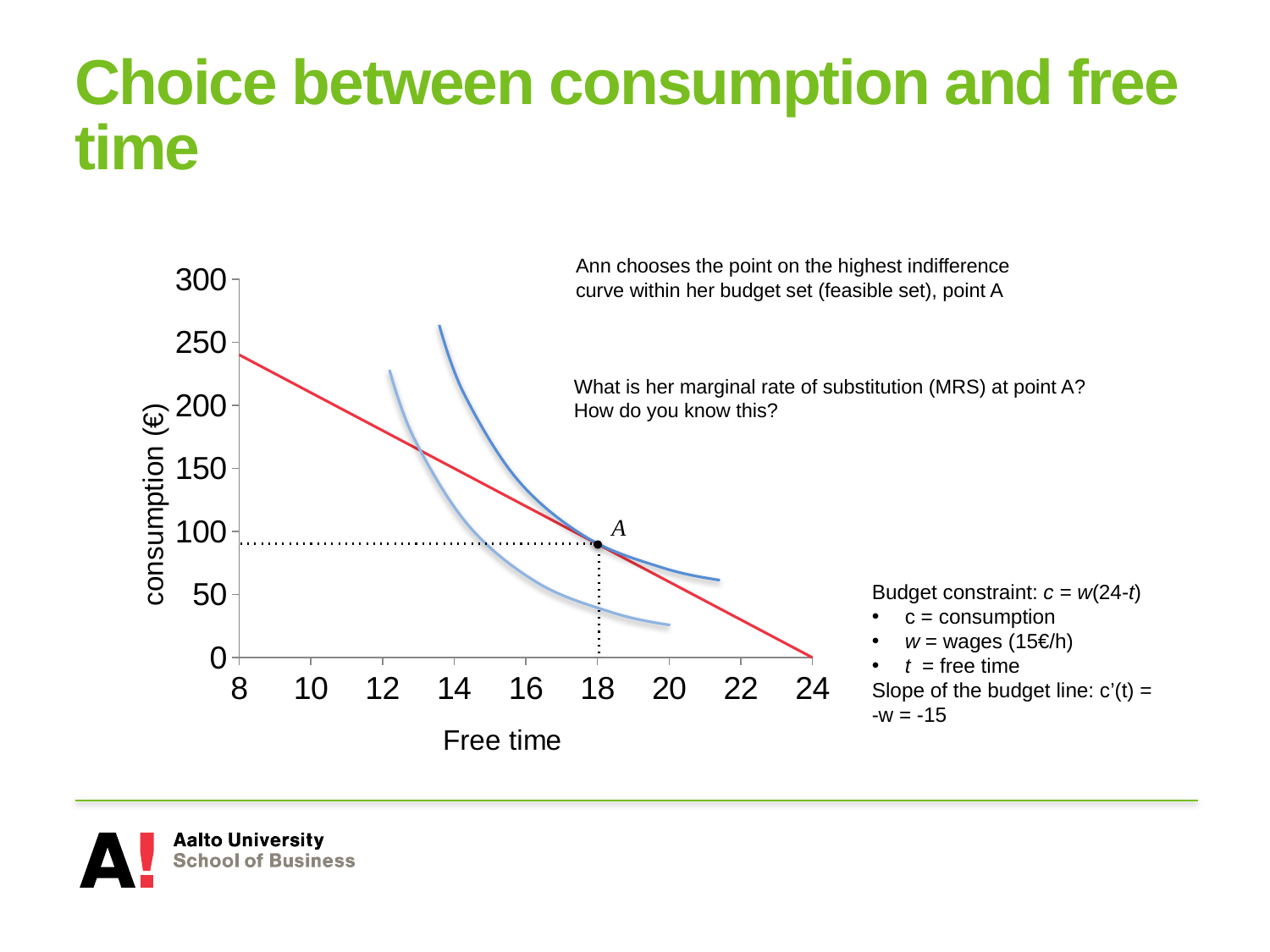
How much free time does Ann have at point A? 18 Is consumption at point A greater or less than 50? greater What is the label of the y axis? consumption (€) At what value of free time does the red budget line reach zero consumption? 24 How many blue indifference curves are drawn on the chart? 2 What is the label of the x axis? Free time On the red budget line, is consumption at 8 hours of free time greater or less than 200? greater At 20 hours of free time, which blue indifference curve shows higher consumption, the darker one or the lighter one? the darker one Does consumption along the red budget line rise or fall as free time increases? fall What kind of chart is shown on the slide? line chart What is the highest value shown on the consumption axis? 300 Is consumption at point A greater or less than 100? less